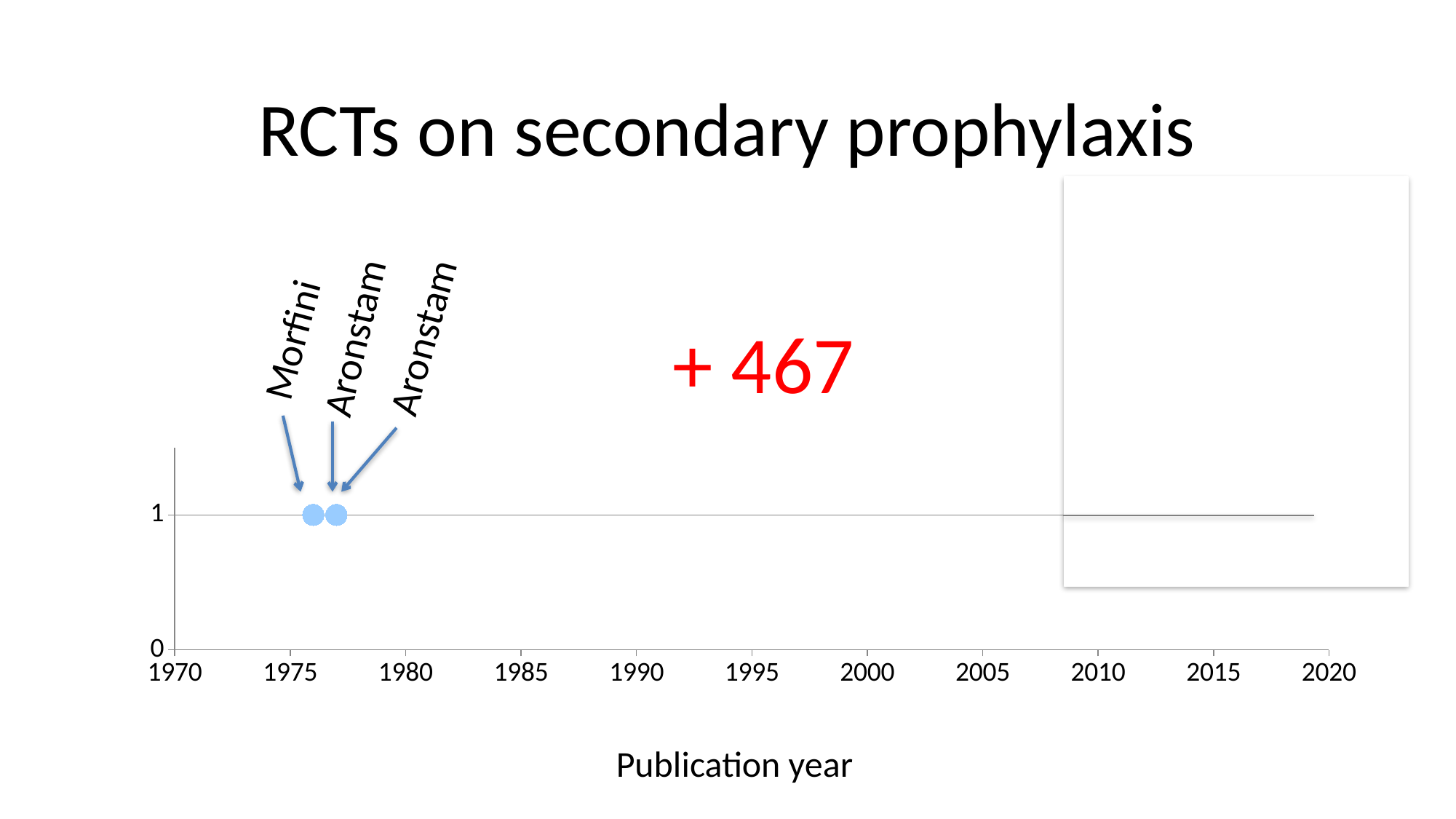
Is the publication year of the Morfini point greater or less than 1975? greater Is the publication year of the Morfini point greater or less than 1980? less What is the highest value shown on the y axis? 1 What is the title of the chart on the slide? RCTs on secondary prophylaxis What is the label of the x axis of the chart? Publication year What kind of chart is shown on the slide? scatter chart What y-axis value do the plotted points lie on? 1 What is the last year shown on the x axis? 2020 What number is written in red on the chart? + 467 How many distinct author labels point to the plotted points? 3 Is the publication year of the Aronstam points greater or less than 1985? less What is the first year shown on the x axis? 1970